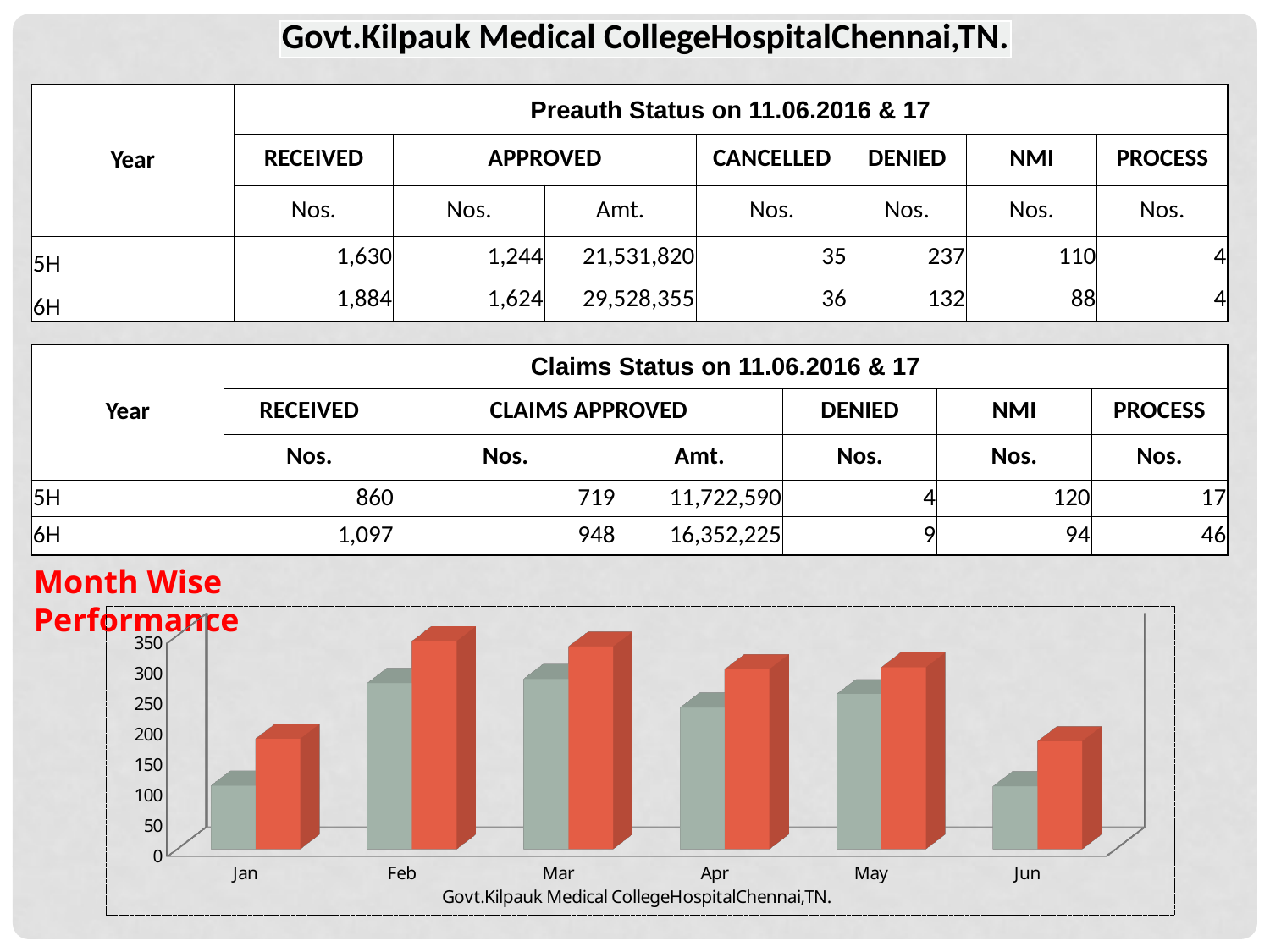
Is the value of the red bar for Feb greater or less than 300? greater In the bar chart, which red bar is taller: Feb or Apr? Feb In the bar chart, which is larger for Jan: the grey bar or the red bar? the red bar Is the value of the grey bar for Apr greater or less than 200? greater What kind of chart is shown under the heading 'Month Wise Performance'? bar chart In the bar chart, do the red bars rise or fall from May to Jun? fall Is the value of the red bar for Jun greater or less than 250? less What is the highest tick value shown on the vertical axis of the bar chart? 350 In the bar chart, do the grey bars rise or fall from Jan to Feb? rise How many bars are plotted for each month in the bar chart? 2 How many months are shown on the x axis of the bar chart? 6